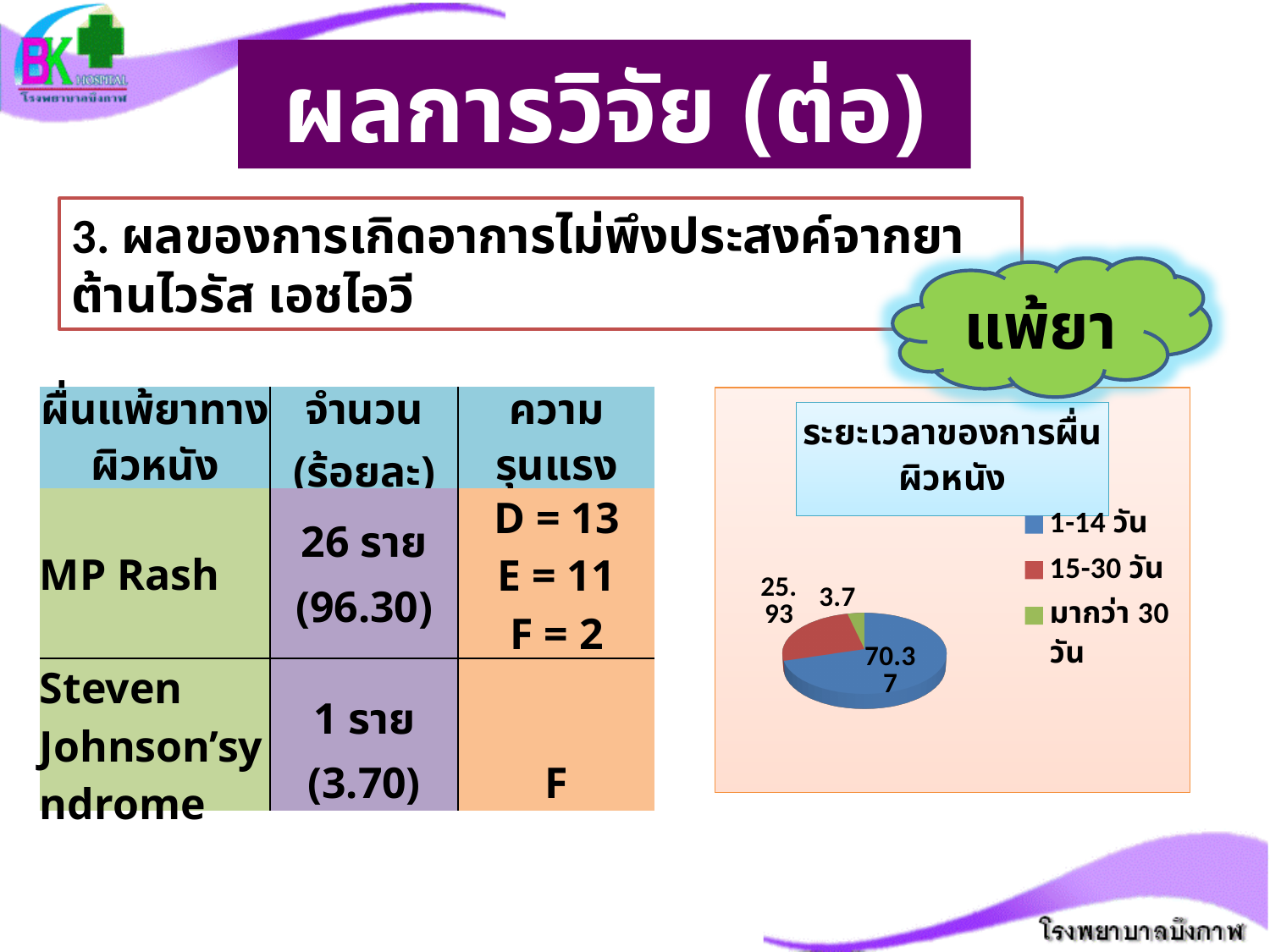
What is the title of the pie chart? ระยะเวลาของการผื่นผิวหนัง What colour is the 1-14 วัน slice in the pie chart? blue What is the value for 1-14 วัน in the pie chart? 70.37 Which category has the largest slice in the pie chart? 1-14 วัน How many entries does the legend of the pie chart list? 3 What is the value for มากกว่า 30 วัน in the pie chart? 3.7 Which category has the smallest slice in the pie chart? มากว่า 30 วัน Which is larger in the pie chart, 15-30 วัน or มากกว่า 30 วัน? 15-30 วัน How many categories does the pie chart show? 3 What is the value for 15-30 วัน in the pie chart? 25.93 What type of chart is shown on the slide? pie chart What is the difference between the values for 1-14 วัน and 15-30 วัน in the pie chart? 44.44